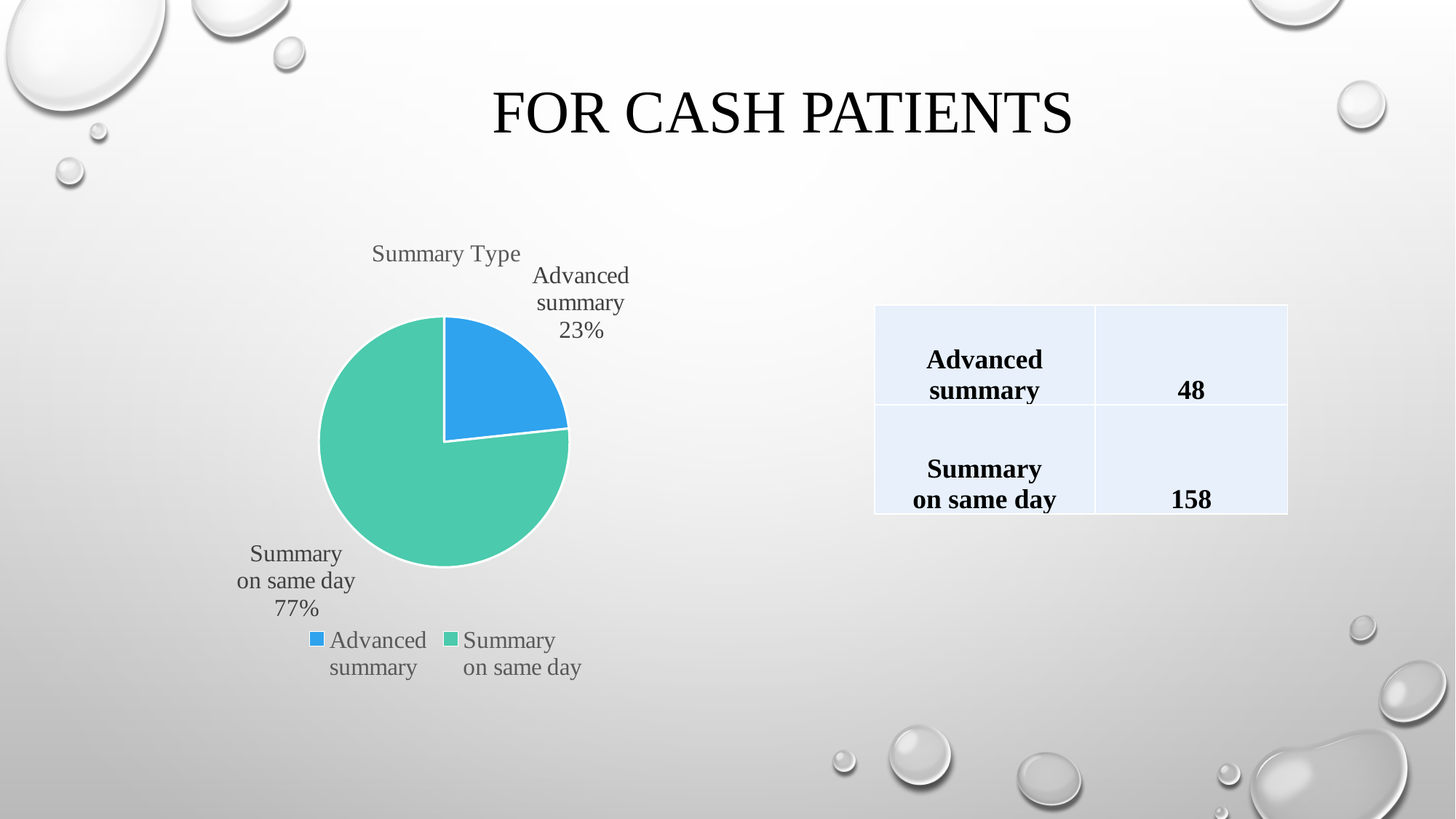
What is the title of the chart? Summary Type Which category has the largest slice of the pie? Summary on same day What colour is the Advanced summary slice? blue What share of the pie does Summary on same day represent? 77% Which is larger, the share for Advanced summary or the share for Summary on same day? Summary on same day What type of chart is shown on the slide? pie chart How many entries does the legend list? 2 What is the difference in percentage points between the Summary on same day share and the Advanced summary share? 54 How many slices does the pie chart have? 2 Which category has the smallest slice of the pie? Advanced summary What share of the pie does Advanced summary represent? 23%